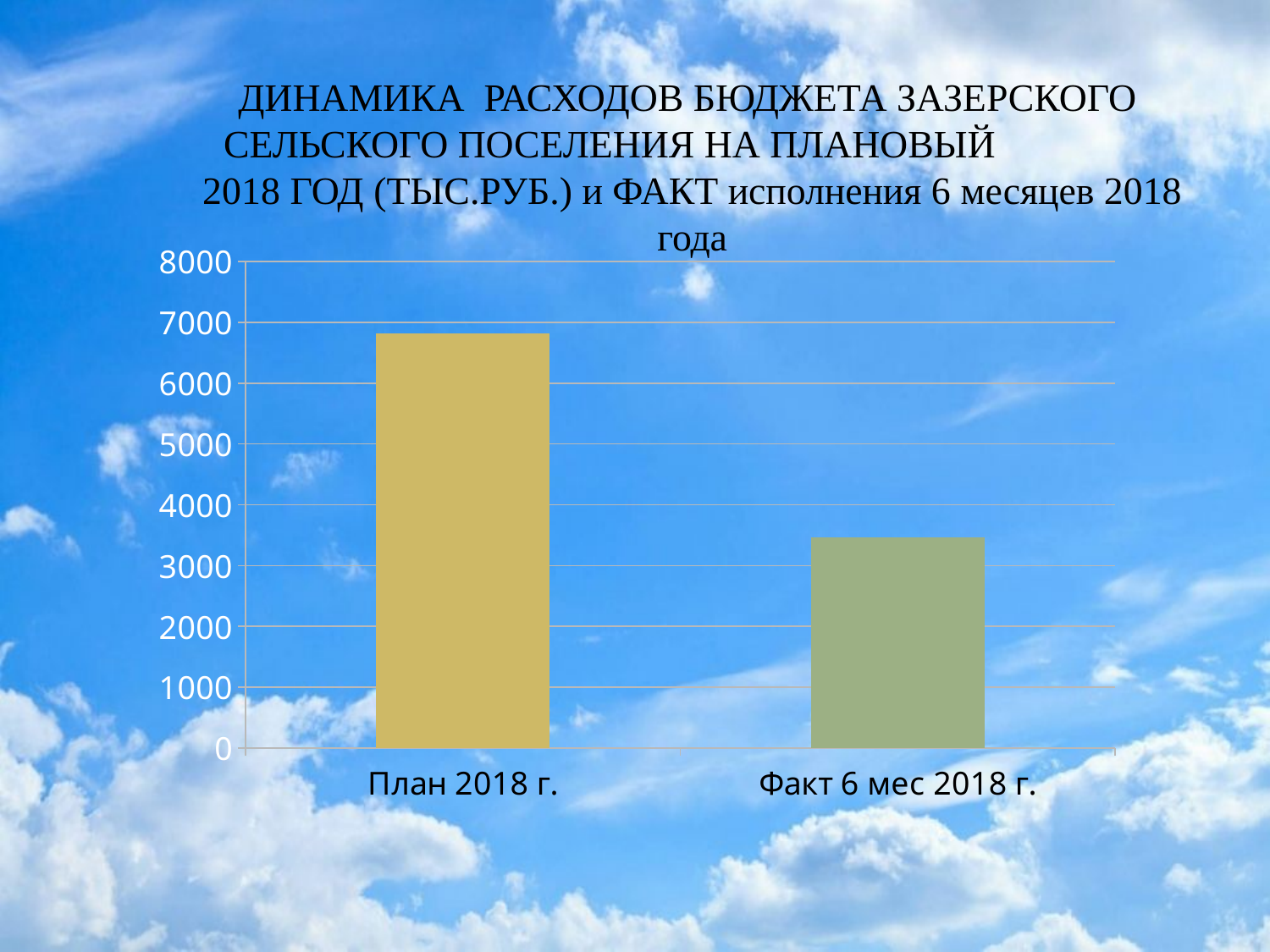
Which is larger, the value for План 2018 г. or the value for Факт 6 мес 2018 г.? План 2018 г. Is the value for Факт 6 мес 2018 г. greater or less than 3000? greater Is the value for Факт 6 мес 2018 г. greater or less than 4000? less What kind of chart is shown on the slide? bar chart Is the value for План 2018 г. greater or less than 6000? greater Do the values rise or fall from left to right along the x axis? fall How many bars (categories) does the chart show? 2 Which category has the highest value? План 2018 г. Which category has the lowest value? Факт 6 мес 2018 г. What is the highest value shown on the vertical axis? 8000 What is the label of the right-hand bar? Факт 6 мес 2018 г.